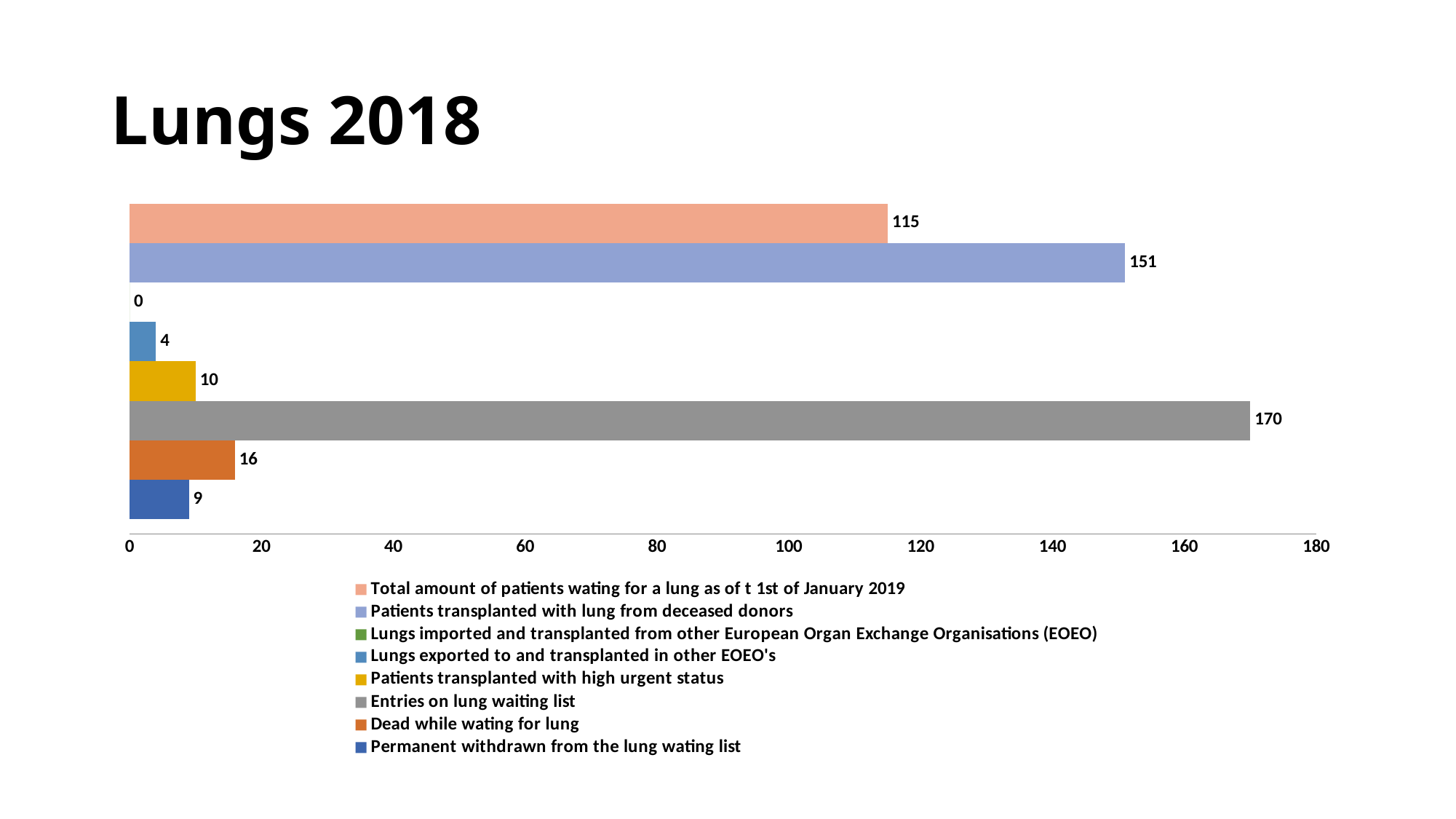
What is the value for Lungs imported and transplanted from other European Organ Exchange Organisations (EOEO)? 0 What kind of chart is shown on the slide? bar chart Is the value for Total amount of patients wating for a lung as of t 1st of January 2019 greater or less than 100? greater Which series has the highest value? Entries on lung waiting list What is the value for Patients transplanted with lung from deceased donors? 151 What is the title of the slide? Lungs 2018 How many series does the legend list? 8 Which is larger: Dead while wating for lung or Permanent withdrawn from the lung wating list? Dead while wating for lung What is the difference between Entries on lung waiting list and Patients transplanted with lung from deceased donors? 19 Which series has the lowest value? Lungs imported and transplanted from other European Organ Exchange Organisations (EOEO) What is the value for Entries on lung waiting list? 170 What is the value for Dead while wating for lung? 16